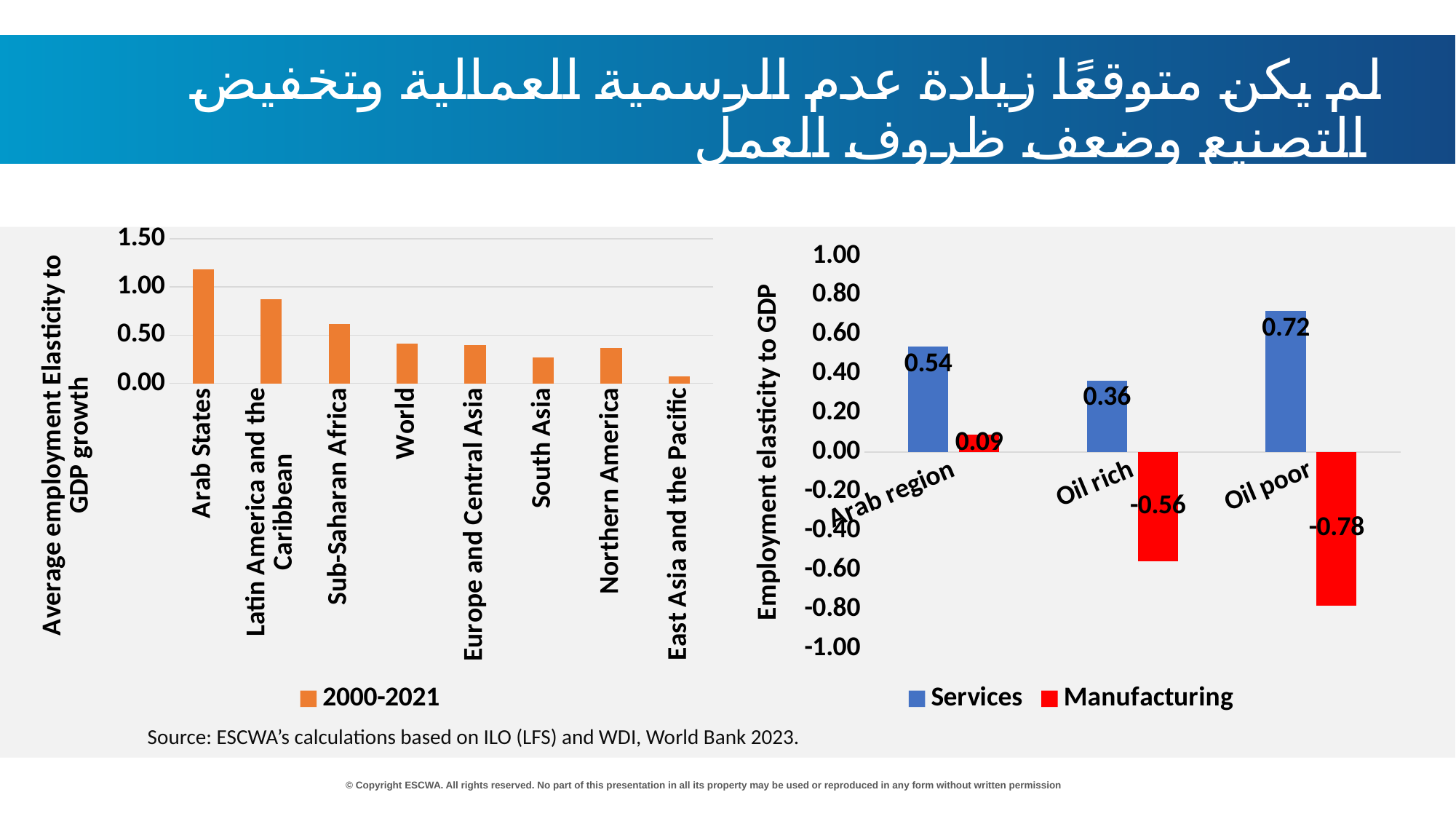
On the right chart, how many series does the legend list? 2 On the left chart, which region has the lowest average employment elasticity to GDP growth? East Asia and the Pacific On the right chart, what is the Manufacturing value for Oil poor? -0.78 On the left chart, which region has the highest average employment elasticity to GDP growth? Arab States On the left chart, what period does the legend entry refer to? 2000-2021 What type of chart is the right chart? Bar chart On the left chart, is the value for East Asia and the Pacific greater or less than 0.50? less On the right chart, what is the Services value for the Arab region? 0.54 On the right chart, what is the difference between the Services values for Oil poor and Oil rich? 0.36 On the left chart, which is larger, the value for Sub-Saharan Africa or the value for South Asia? Sub-Saharan Africa On the left chart, how many regions are shown on the x axis? 8 On the left chart, is the value for Arab States greater or less than 1.00? greater